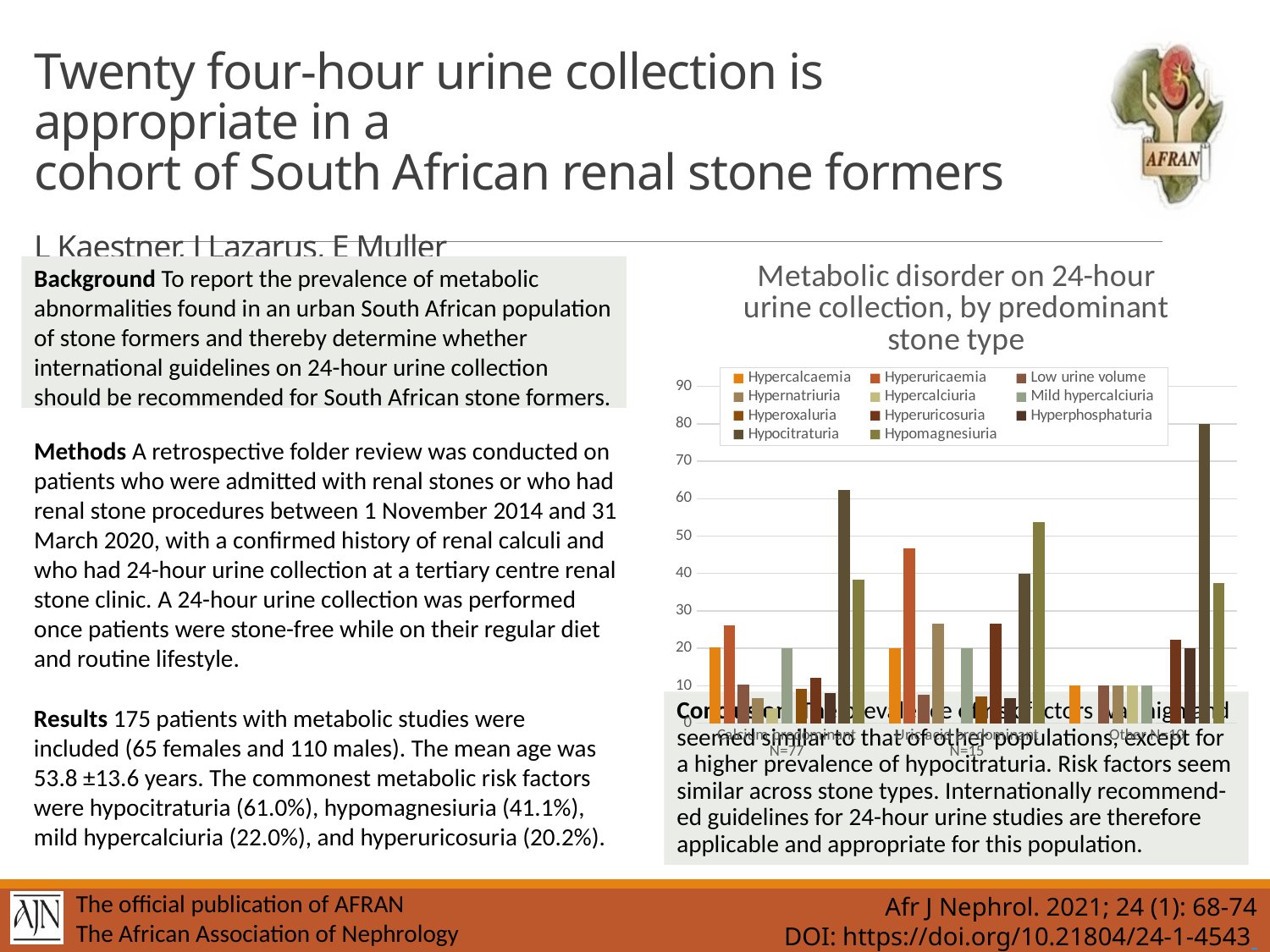
How many stone-type categories are shown on the x axis of the chart? 3 Is the value for Hypomagnesiuria in the Uric acid predominant group greater or less than 40? greater How many series does the chart legend list? 11 Which metabolic disorder has the tallest bar in the Calcium predominant group? Hypocitraturia Is the value for Hypercalcaemia in the Calcium predominant group greater or less than 30? less Which is larger: Hyperuricaemia in the Uric acid predominant group or Hyperuricaemia in the Calcium predominant group? Uric acid predominant Is the value for Hyperuricaemia in the Uric acid predominant group greater or less than 40? greater What is the title of the chart? Metabolic disorder on 24-hour urine collection, by predominant stone type Which is larger: Hypocitraturia in the Other group or Hypocitraturia in the Calcium predominant group? Other What type of chart is shown on the slide? Bar chart